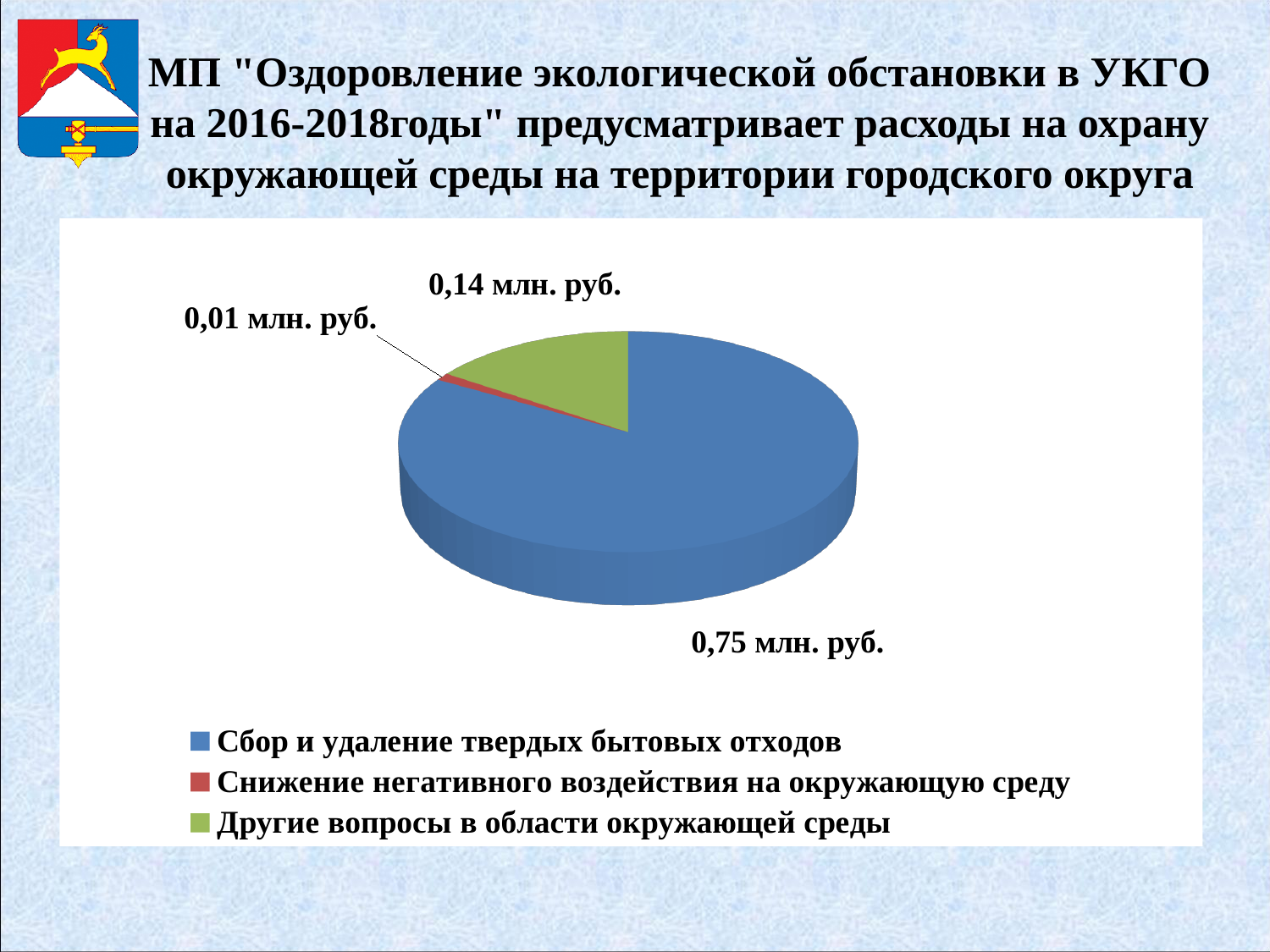
Which category has the smallest slice of the pie? Снижение негативного воздействия на окружающую среду What is the value for "Снижение негативного воздействия на окружающую среду"? 0,01 млн. руб. What colour is the slice for "Другие вопросы в области окружающей среды"? Green What type of chart is shown on the slide? Pie chart What is the difference between the values for "Сбор и удаление твердых бытовых отходов" and "Другие вопросы в области окружающей среды"? 0,61 млн. руб. What is the total of all three slices of the pie chart? 0,90 млн. руб. What colour is the slice for "Сбор и удаление твердых бытовых отходов"? Blue Which category has the largest slice of the pie? Сбор и удаление твердых бытовых отходов How many categories does the pie chart show? 3 What is the value for "Сбор и удаление твердых бытовых отходов"? 0,75 млн. руб. Which is larger: the value for "Другие вопросы в области окружающей среды" or for "Снижение негативного воздействия на окружающую среду"? Другие вопросы в области окружающей среды What is the value for "Другие вопросы в области окружающей среды"? 0,14 млн. руб.